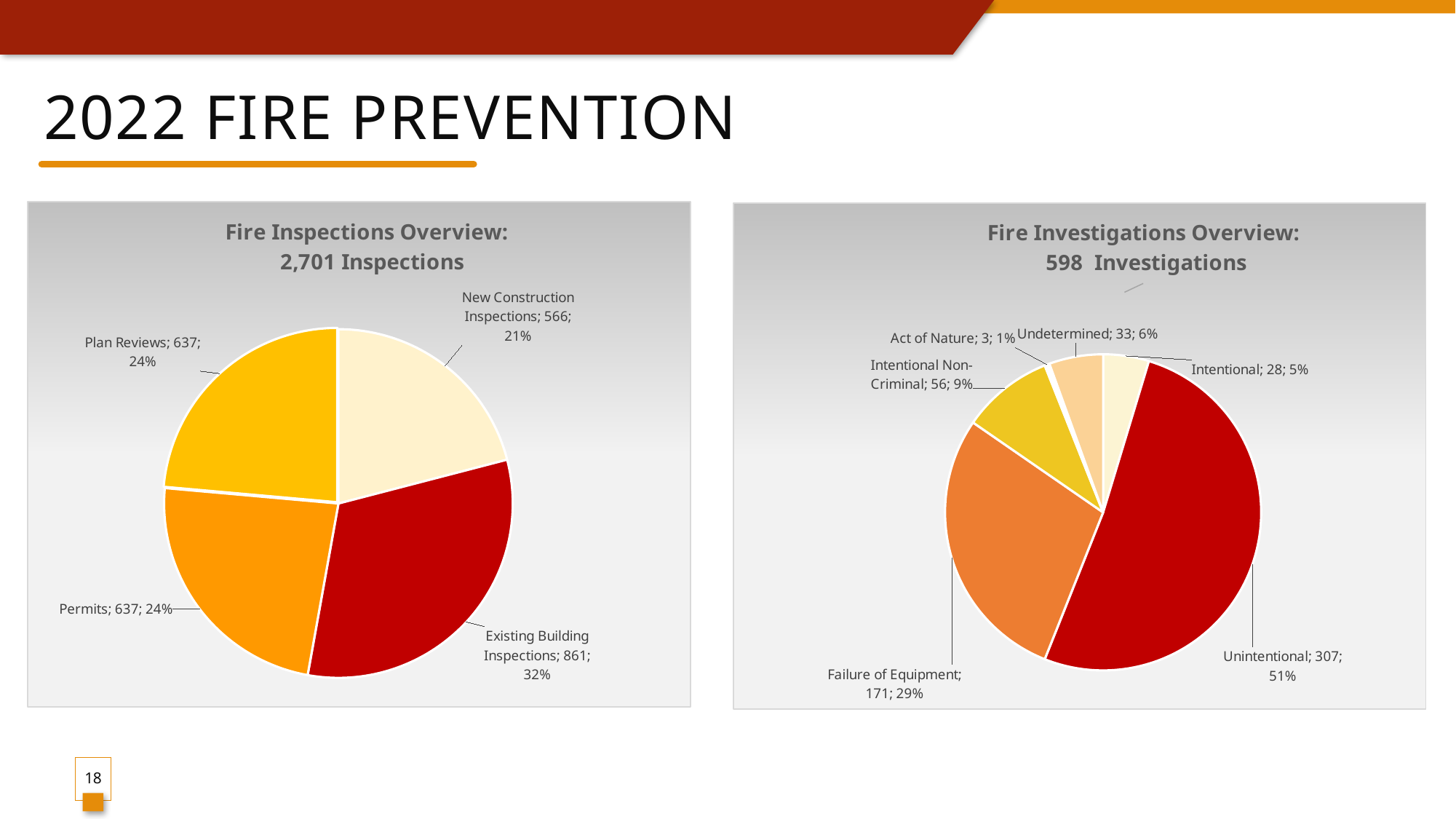
What type of chart is the Fire Investigations Overview chart? Pie chart In the Fire Inspections Overview chart, how many Existing Building Inspections were there? 861 In the Fire Inspections Overview chart, which category has the smallest slice? New Construction Inspections In the Fire Investigations Overview chart, which is larger: Intentional Non-Criminal or Undetermined? Intentional Non-Criminal In the Fire Inspections Overview chart, what share of the pie is New Construction Inspections? 21% In the Fire Inspections Overview chart, which category has the largest slice? Existing Building Inspections In the Fire Investigations Overview chart, what share of the pie is Unintentional? 51% In the Fire Investigations Overview chart, which category has the smallest slice? Act of Nature How many categories are shown in the Fire Inspections Overview pie chart? 4 How many categories are shown in the Fire Investigations Overview pie chart? 6 In the Fire Investigations Overview chart, how many investigations were Failure of Equipment? 171 In the Fire Inspections Overview chart, what is the difference between Existing Building Inspections and Plan Reviews? 224